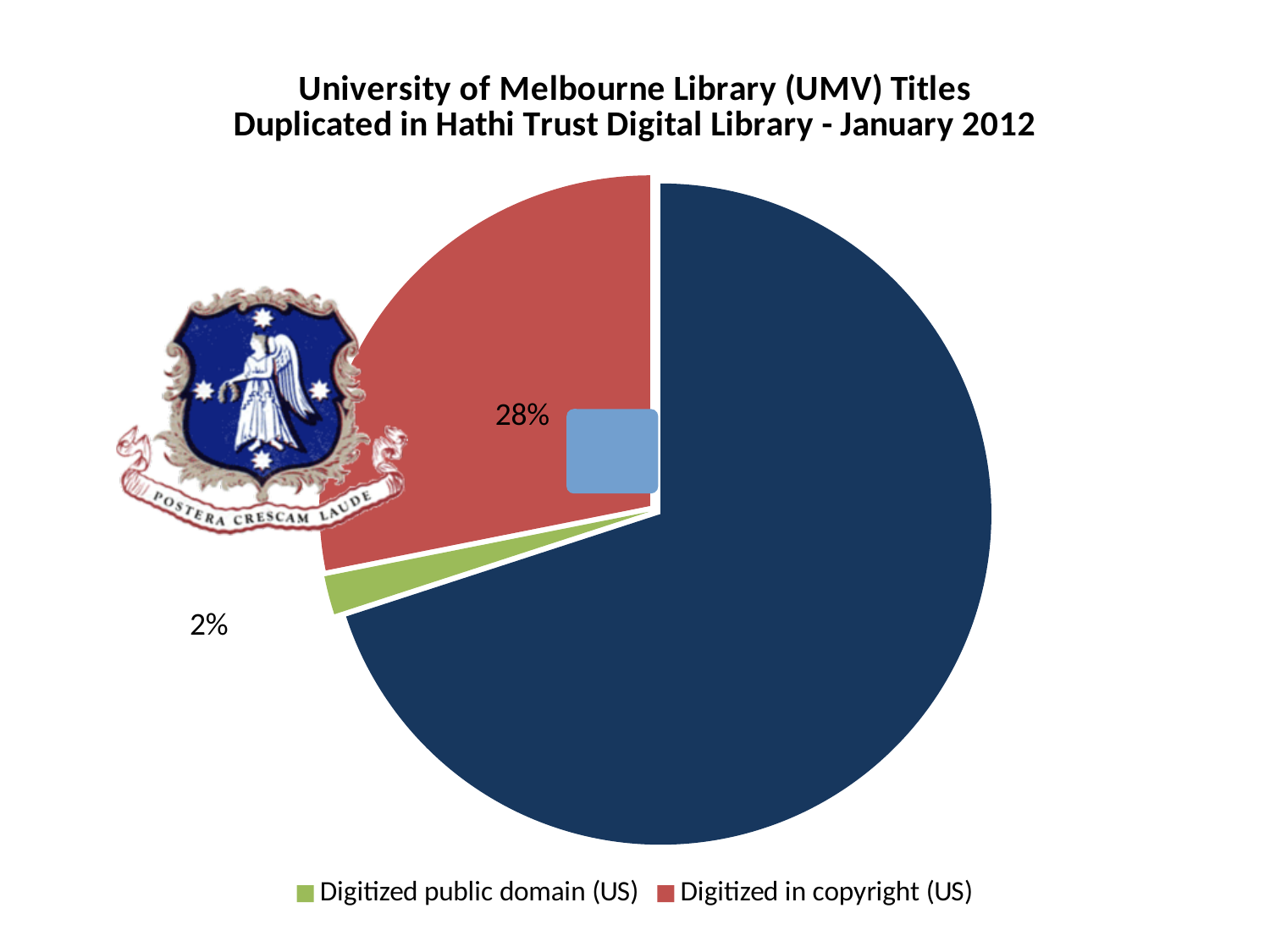
What kind of chart is shown on the slide? Pie chart What share of the pie does the Digitized public domain (US) slice represent? 2% What colour is the Digitized in copyright (US) slice? Red What percentage of the pie is labelled for Digitized public domain (US)? 2% What percentage of the pie is labelled for Digitized in copyright (US)? 28% What is the difference in percentage points between the Digitized in copyright (US) slice and the Digitized public domain (US) slice? 26% Which is larger, the Digitized in copyright (US) slice or the Digitized public domain (US) slice? Digitized in copyright (US) Which category has the smallest slice of the pie? Digitized public domain (US) How many entries does the legend list? 2 How many slices does the pie chart have? 3 What is the title of the chart? University of Melbourne Library (UMV) Titles Duplicated in Hathi Trust Digital Library - January 2012